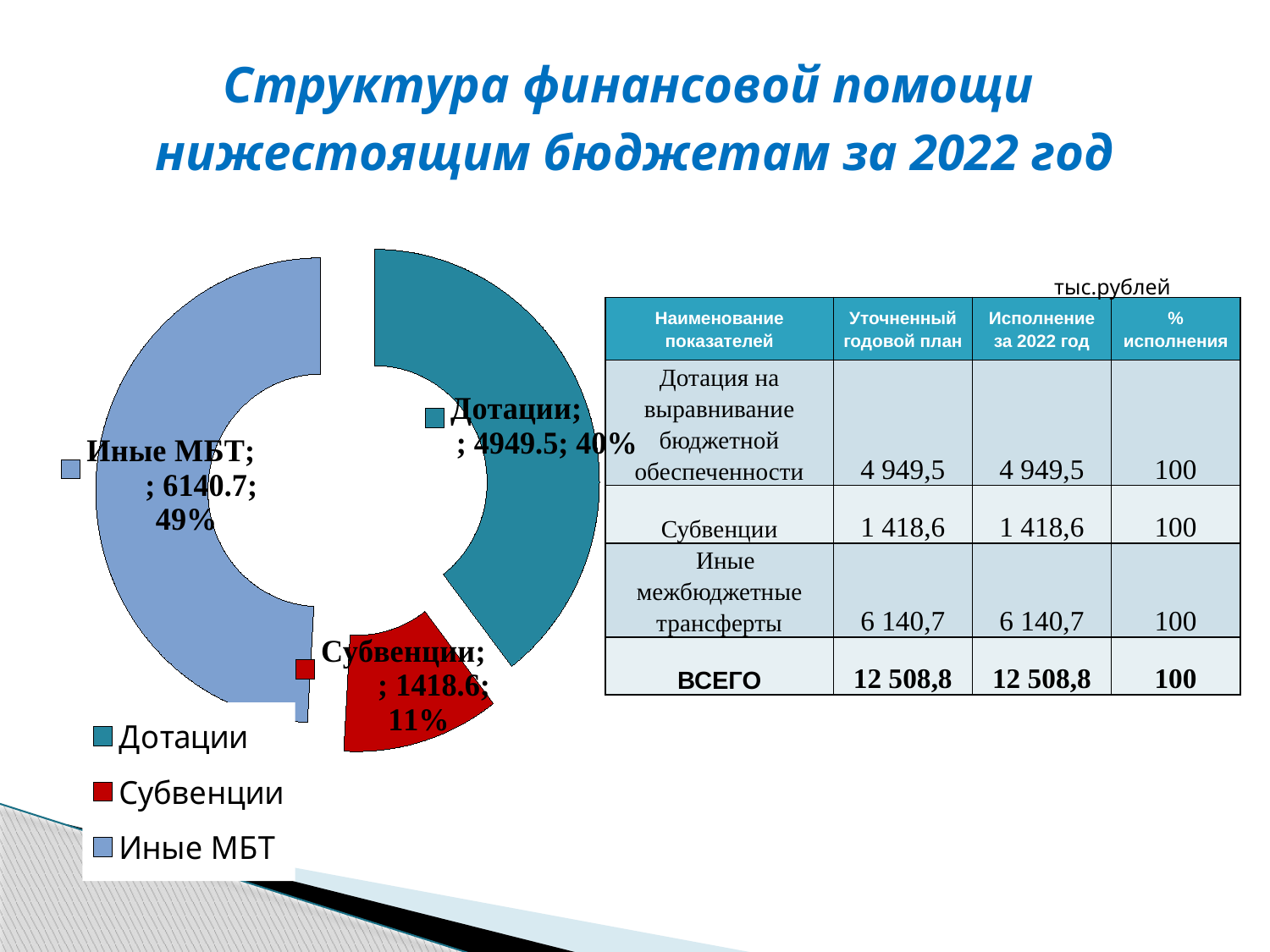
Which is larger, the value for Дотации or the value for Субвенции? Дотации What is the value shown for Дотации in the chart? 4949.5 What is the value shown for Иные МБТ in the chart? 6140.7 What share of the chart does Дотации represent? 40% Which category has the largest slice in the chart? Иные МБТ What type of chart is shown on the slide? Doughnut (pie) chart How many entries does the chart legend list? 3 Which category has the smallest slice in the chart? Субвенции What share of the chart does Иные МБТ represent? 49% What share of the chart does Субвенции represent? 11% What is the value shown for Субвенции in the chart? 1418.6 What is the difference between the values for Иные МБТ and Дотации? 1191.2